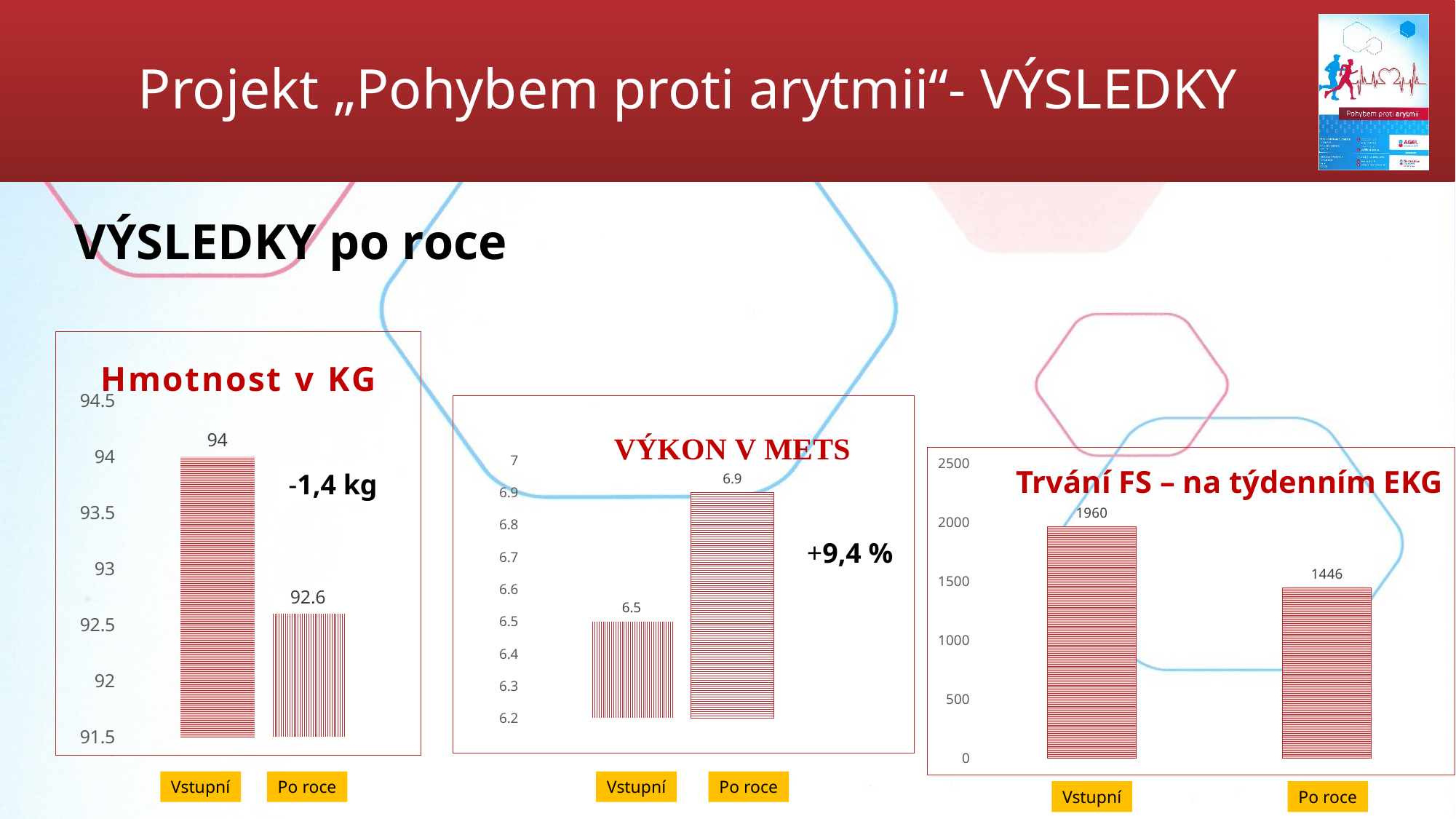
In the 'VÝKON V METS' chart, what is the value for Vstupní? 6.5 In the 'Hmotnost v KG' chart, what is the difference between the Vstupní and Po roce values? 1.4 In the 'Trvání FS – na týdenním EKG' chart, what is the value for Vstupní? 1960 In the 'Hmotnost v KG' chart, what is the value for Vstupní? 94 In the 'Trvání FS – na týdenním EKG' chart, what is the value for Po roce? 1446 How many categories are shown in the 'VÝKON V METS' chart? 2 In the 'VÝKON V METS' chart, what is the value for Po roce? 6.9 In the 'Trvání FS – na týdenním EKG' chart, which category has the lowest value? Po roce In the 'Hmotnost v KG' chart, what is the value for Po roce? 92.6 In the 'Trvání FS – na týdenním EKG' chart, what is the difference between the Vstupní and Po roce values? 514 In the 'VÝKON V METS' chart, which category has the higher value? Po roce What kind of chart is the 'Hmotnost v KG' chart? Bar chart